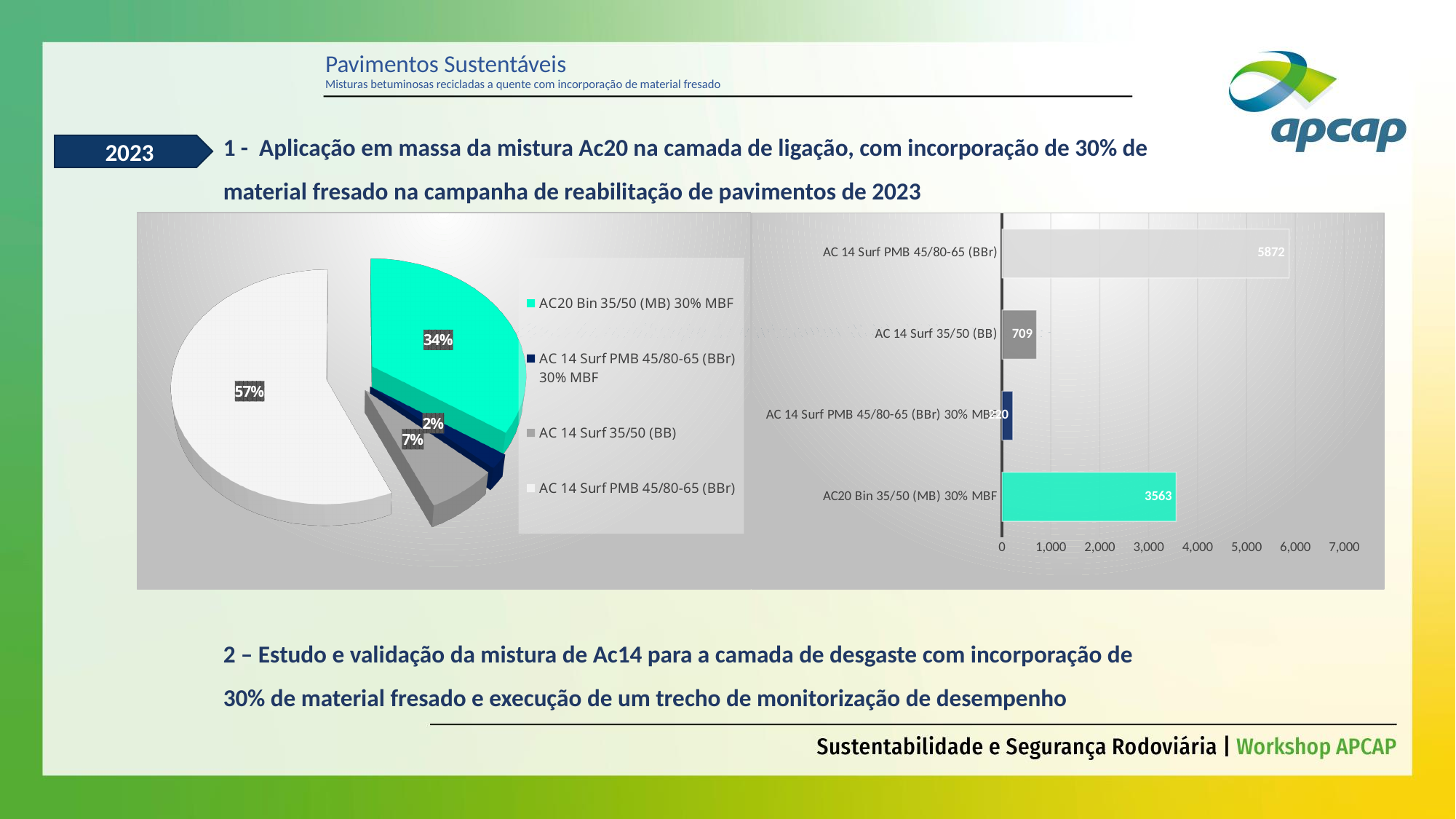
In the pie chart on the left, what share does the AC20 Bin 35/50 (MB) 30% MBF slice have? 34% In the bar chart on the right, what is the difference between the values for AC 14 Surf PMB 45/80-65 (BBr) and AC20 Bin 35/50 (MB) 30% MBF? 2309 In the bar chart on the right, is the value for AC 14 Surf PMB 45/80-65 (BBr) 30% MBF greater or less than 1,000? less In the bar chart on the right, what is the value for AC20 Bin 35/50 (MB) 30% MBF? 3563 In the bar chart on the right, what is the value for AC 14 Surf 35/50 (BB)? 709 How many entries does the legend of the pie chart on the left list? 4 In the bar chart on the right, what is the value for AC 14 Surf PMB 45/80-65 (BBr)? 5872 In the bar chart on the right, which category has the highest value? AC 14 Surf PMB 45/80-65 (BBr) What kind of chart is the chart on the right of the slide? bar chart In the pie chart on the left, what share does the AC 14 Surf PMB 45/80-65 (BBr) slice have? 57% In the pie chart on the left, which slice is the smallest? AC 14 Surf PMB 45/80-65 (BBr) 30% MBF What kind of chart is the chart on the left of the slide? pie chart